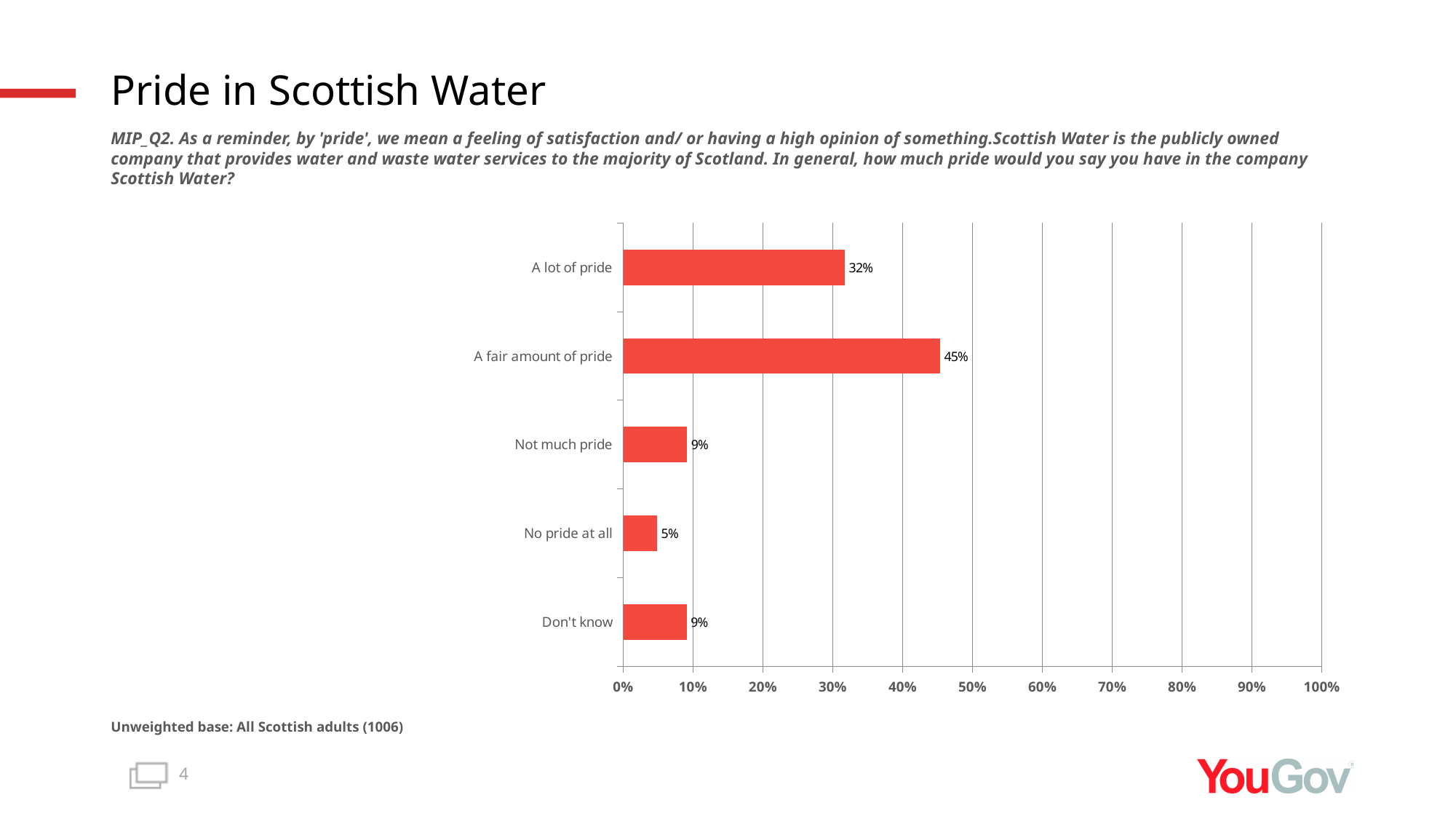
What is the combined value of 'A lot of pride' and 'A fair amount of pride'? 77% What is the value for 'Don't know'? 9% How many categories are shown in the chart? 5 Which category has the lowest value? No pride at all What kind of chart is shown on the slide? Bar chart What is the difference between 'A fair amount of pride' and 'A lot of pride'? 13% Which is larger, 'Not much pride' or 'No pride at all'? Not much pride What is the maximum value shown on the x axis? 100% What percentage of respondents said they have a lot of pride in Scottish Water? 32% What is the value for 'A fair amount of pride'? 45% What percentage of respondents said 'No pride at all'? 5% Which category has the highest value? A fair amount of pride